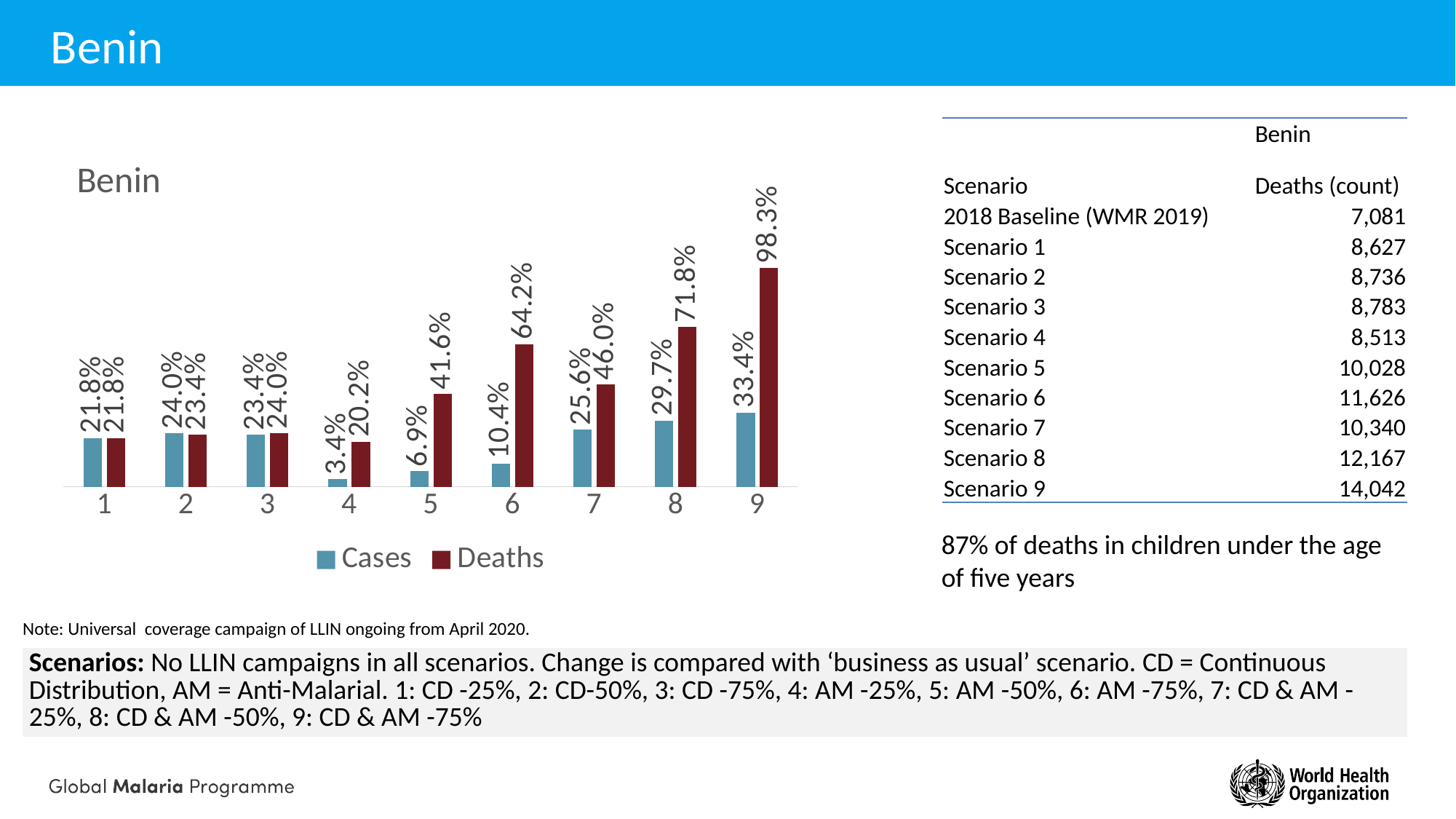
What kind of chart is shown on the slide? Bar chart What is the Deaths value for scenario 9? 98.3% What is the difference between the Deaths values for scenario 8 and scenario 5? 30.2% How many series does the chart legend list? 2 What is the Cases value for scenario 4? 3.4% How many scenarios are shown on the x axis of the chart? 9 Which scenario has the lowest Cases value? 4 What is the Cases value for scenario 7? 25.6% Which is larger for scenario 5, the Cases value or the Deaths value? Deaths What is the Deaths value for scenario 6? 64.2% Which scenario has the highest Deaths value? 9 What is the difference between the Deaths and Cases values for scenario 9? 64.9%